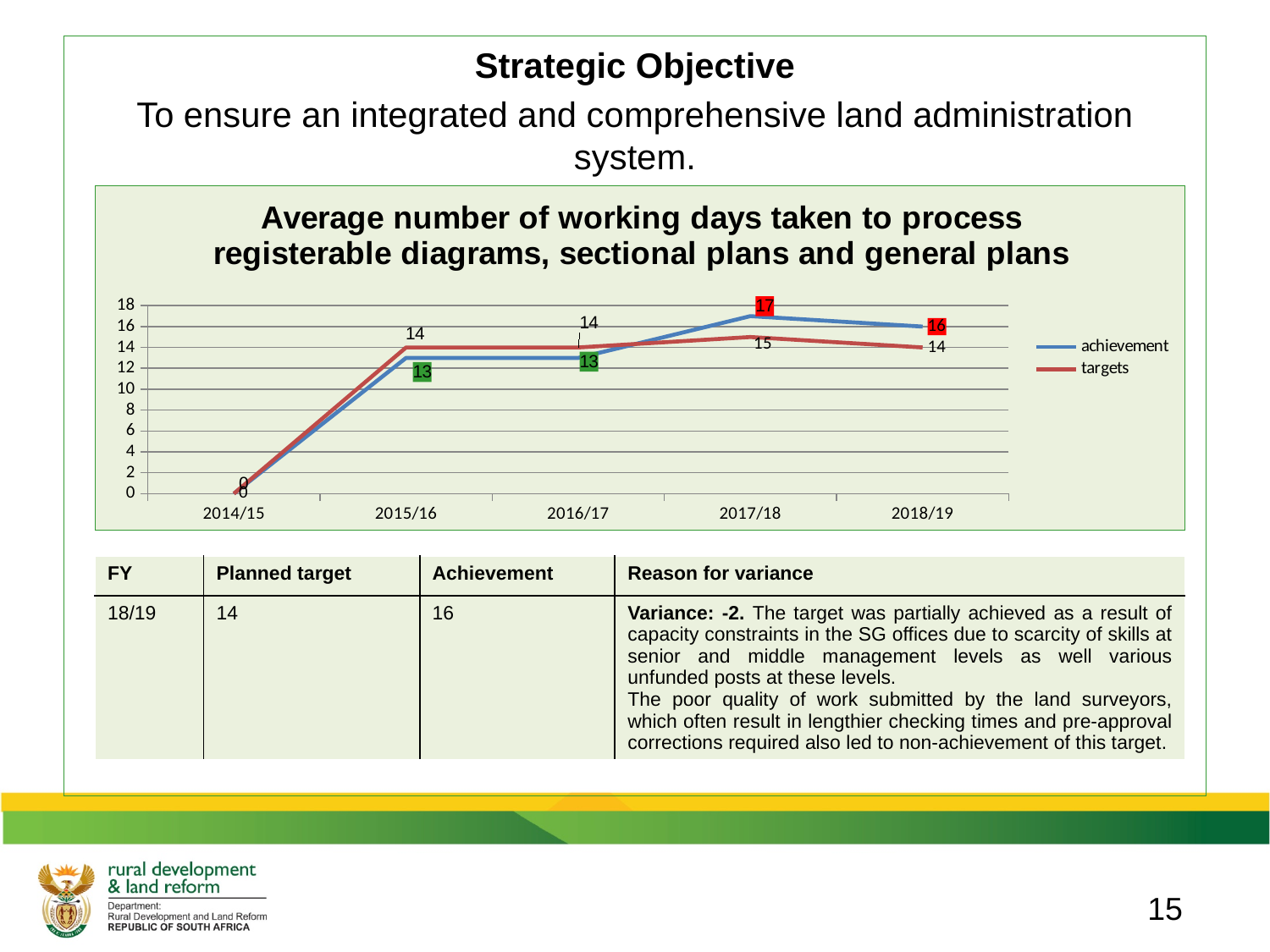
How many series does the chart legend list? 2 How many financial years are plotted along the x axis of the chart? 5 In which financial year is the achievement series at its highest? 2017/18 What type of chart is shown on the slide? line chart What is the targets value for 2018/19? 14 What is the difference between the achievement and targets values in 2018/19? 2 What is the achievement value for 2015/16? 13 What is the title of the chart? Average number of working days taken to process registerable diagrams, sectional plans and general plans Which is larger in 2016/17, the achievement value or the targets value? targets Does the achievement series rise or fall from 2017/18 to 2018/19? fall What is the targets value for 2017/18? 15 What is the achievement value for 2017/18? 17